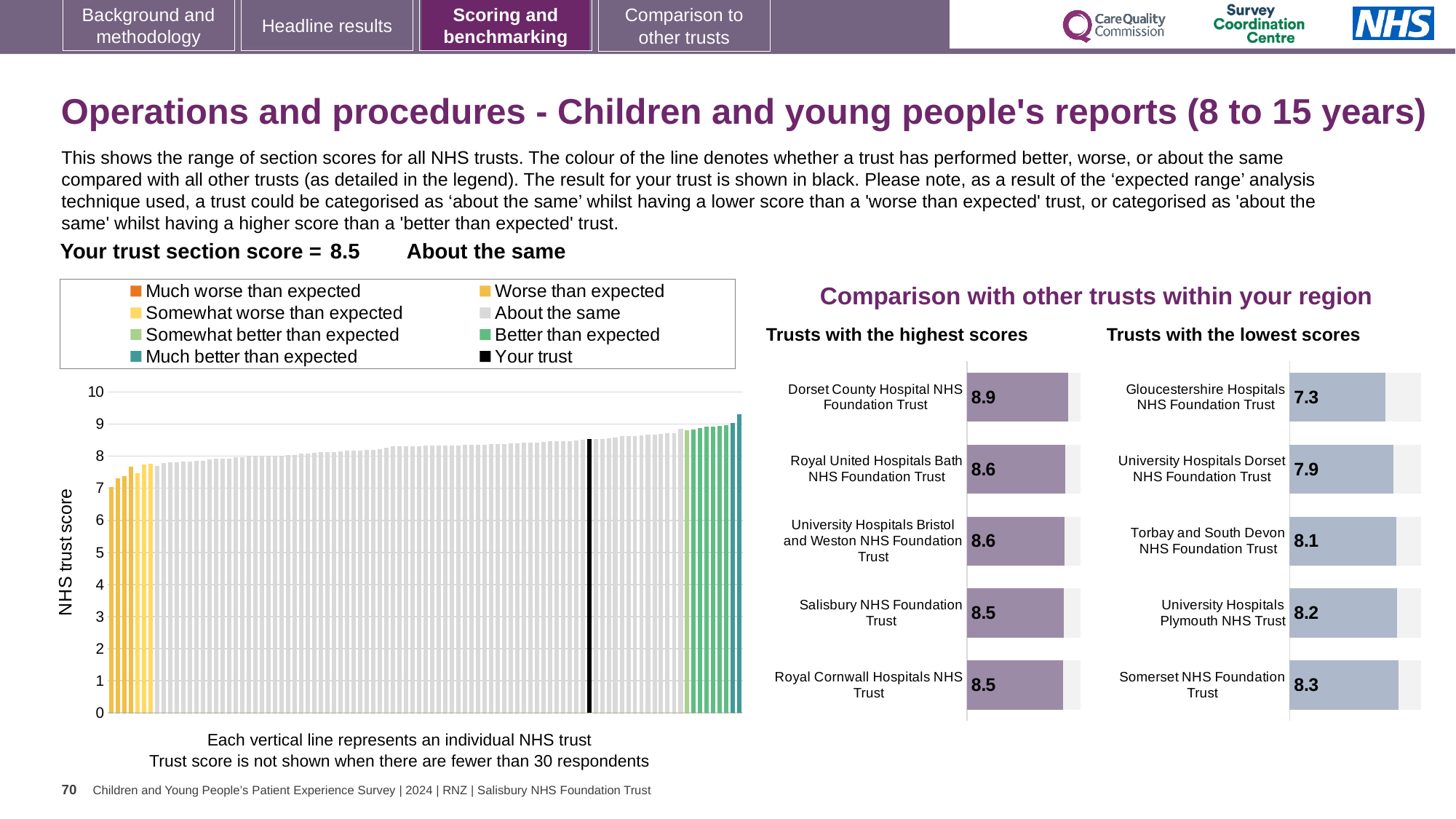
In the 'Trusts with the highest scores' chart, what is the score for Dorset County Hospital NHS Foundation Trust? 8.9 In the 'Trusts with the highest scores' chart, what is the score for Salisbury NHS Foundation Trust? 8.5 In the 'Trusts with the highest scores' chart, which trust has the highest score? Dorset County Hospital NHS Foundation Trust In the 'Trusts with the lowest scores' chart, which trust has the lowest score? Gloucestershire Hospitals NHS Foundation Trust In the 'Trusts with the highest scores' chart, what is the difference between the scores of Dorset County Hospital NHS Foundation Trust and Salisbury NHS Foundation Trust? 0.4 In the 'Trusts with the lowest scores' chart, which has the larger score: University Hospitals Dorset NHS Foundation Trust or Somerset NHS Foundation Trust? Somerset NHS Foundation Trust In the NHS trust score chart on the left, do the bar values rise or fall from left to right? rise In the NHS trust score chart on the left, is the value for the black 'Your trust' bar greater or less than 8? greater In the 'Trusts with the lowest scores' chart, what is the score for Gloucestershire Hospitals NHS Foundation Trust? 7.3 How many entries does the legend of the NHS trust score chart on the left list? 8 In the 'Trusts with the lowest scores' chart, what is the score for Torbay and South Devon NHS Foundation Trust? 8.1 How many trusts are shown in the 'Trusts with the lowest scores' chart? 5